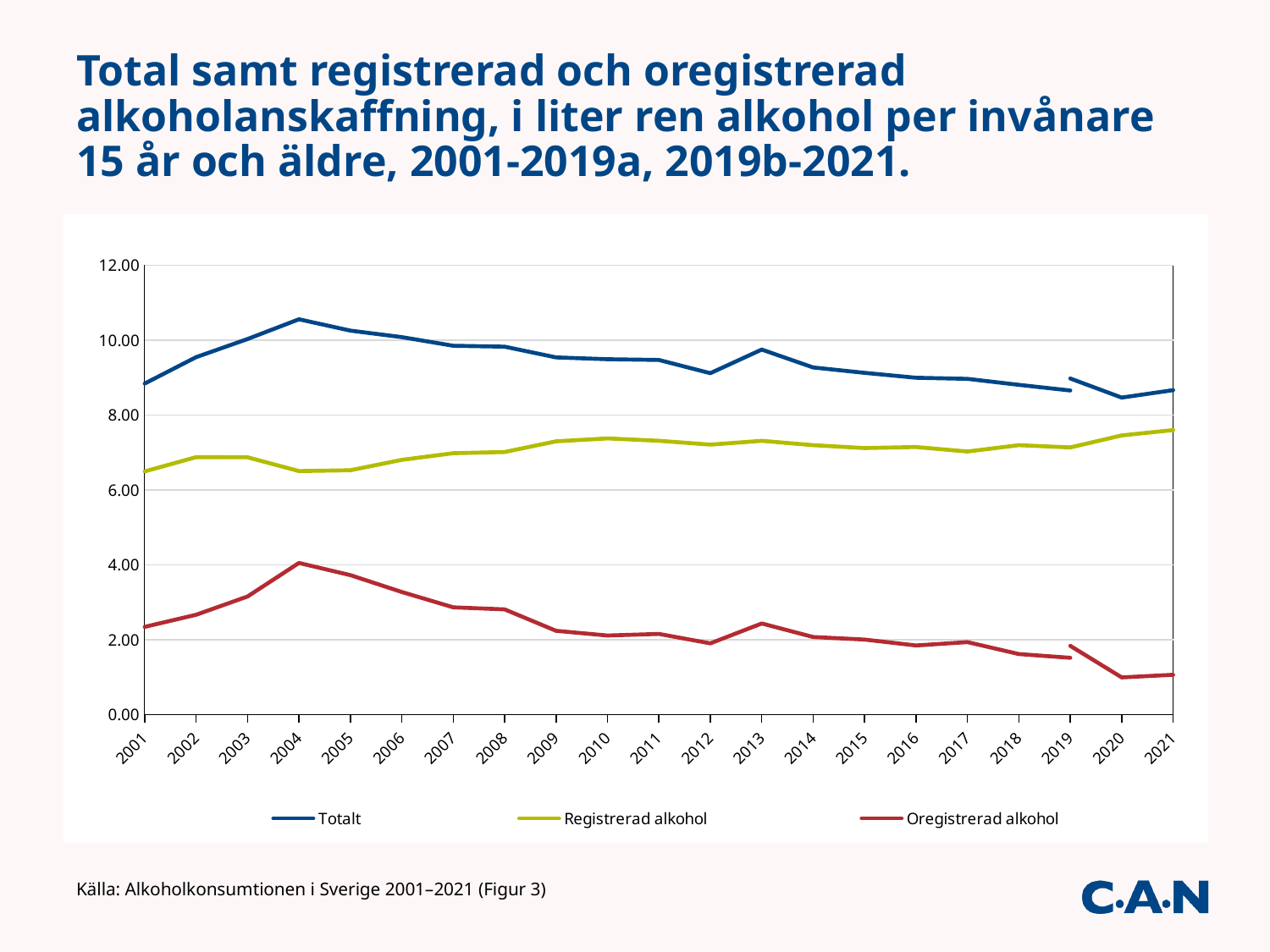
Is the value for Oregistrerad alkohol in 2020 greater or less than 2.00? less Which series is drawn with the red line? Oregistrerad alkohol In which year does the Oregistrerad alkohol series reach its lowest value? 2020 Does the Oregistrerad alkohol series generally rise or fall from 2004 to 2021? fall Is the value for Registrerad alkohol in 2021 greater or less than 8.00? less Which is larger, the Oregistrerad alkohol value in 2001 or in 2021? 2001 In which year does the Oregistrerad alkohol series reach its highest value? 2004 Is the value for Totalt in 2004 greater or less than 10.00? greater How many series does the legend list? 3 How many years are shown on the x axis? 21 What kind of chart is shown on the slide? line chart In which year does the Totalt series reach its highest value? 2004